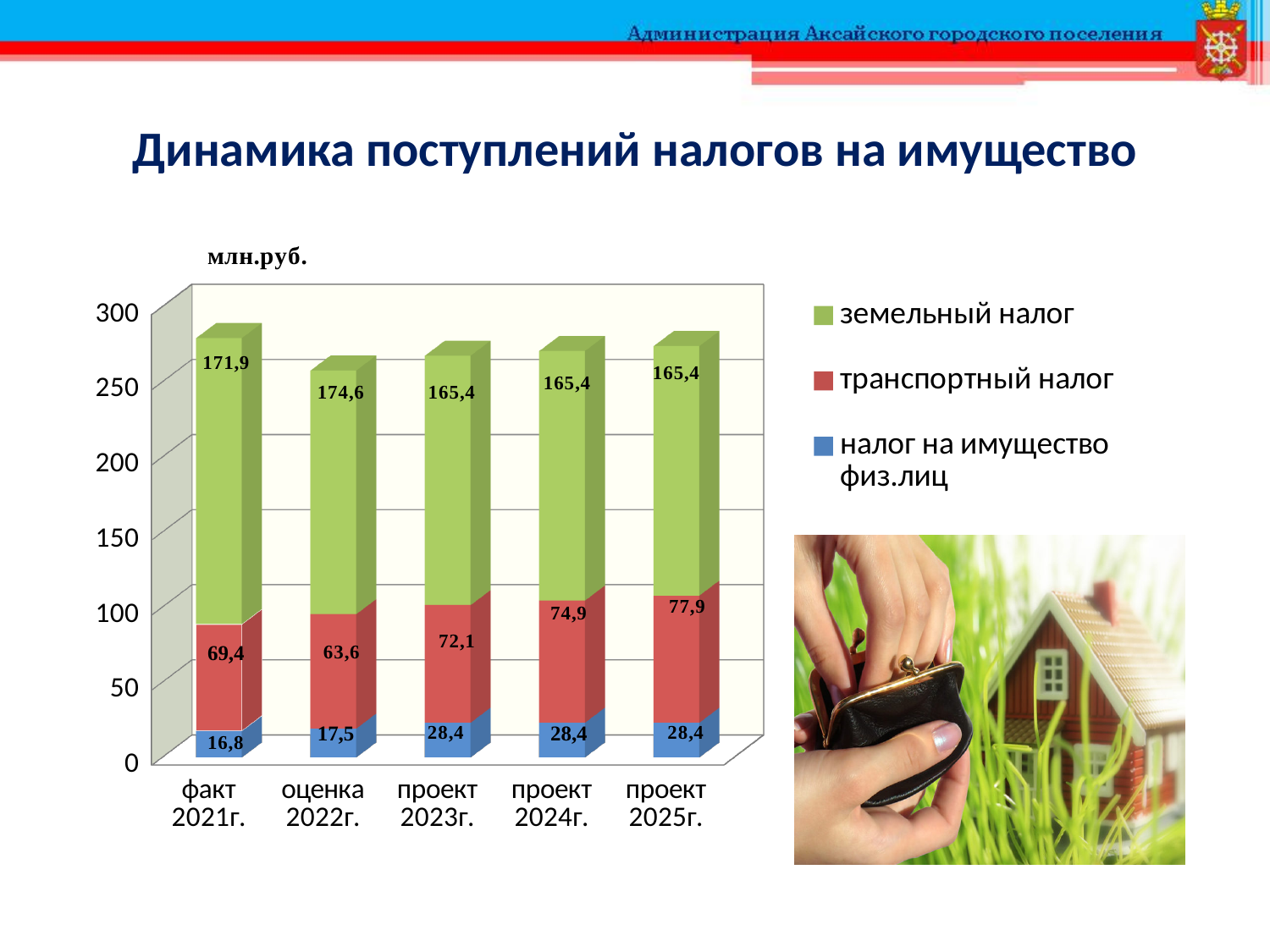
In which category is транспортный налог the highest? проект 2025г. In which category is налог на имущество физ.лиц the lowest? факт 2021г. What type of chart is shown on the slide? stacked bar chart What is the value of земельный налог for оценка 2022г.? 174,6 What is the total of the stacked bar for проект 2025г.? 271,7 What is the difference between транспортный налог for проект 2024г. and оценка 2022г.? 11,3 What is the value of транспортный налог for проект 2025г.? 77,9 What unit is indicated above the chart's vertical axis? млн.руб. How many series does the legend list? 3 Which is larger: земельный налог for факт 2021г. or for проект 2023г.? факт 2021г. What is the value of налог на имущество физ.лиц for факт 2021г.? 16,8 How many categories are shown on the x axis? 5